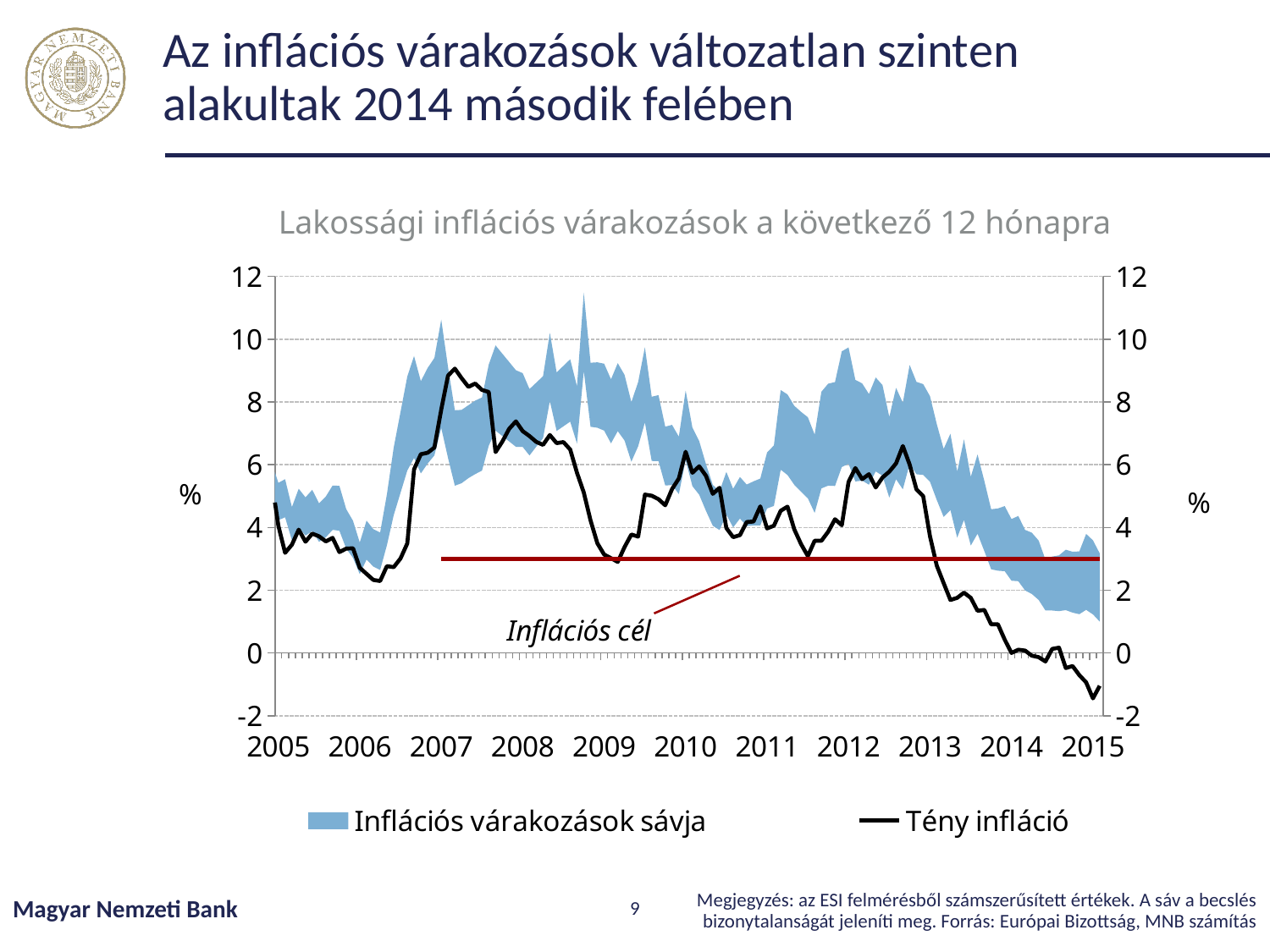
What kind of chart is shown on the slide? area and line chart What is the title of the chart? Lakossági inflációs várakozások a következő 12 hónapra How many year labels are shown on the x axis? 11 Is the value of Tény infláció at the start of 2015 greater or less than 0? less Which is larger: Tény infláció at the start of 2007 or at the start of 2015? 2007 How many series does the chart legend list? 2 Does Tény infláció rise or fall between 2013 and 2015? fall Does Tény infláció rise or fall between 2006 and 2007? rise Is the value of Tény infláció at the start of 2006 greater or less than 4? less What label is given to the horizontal red line on the chart? Inflációs cél